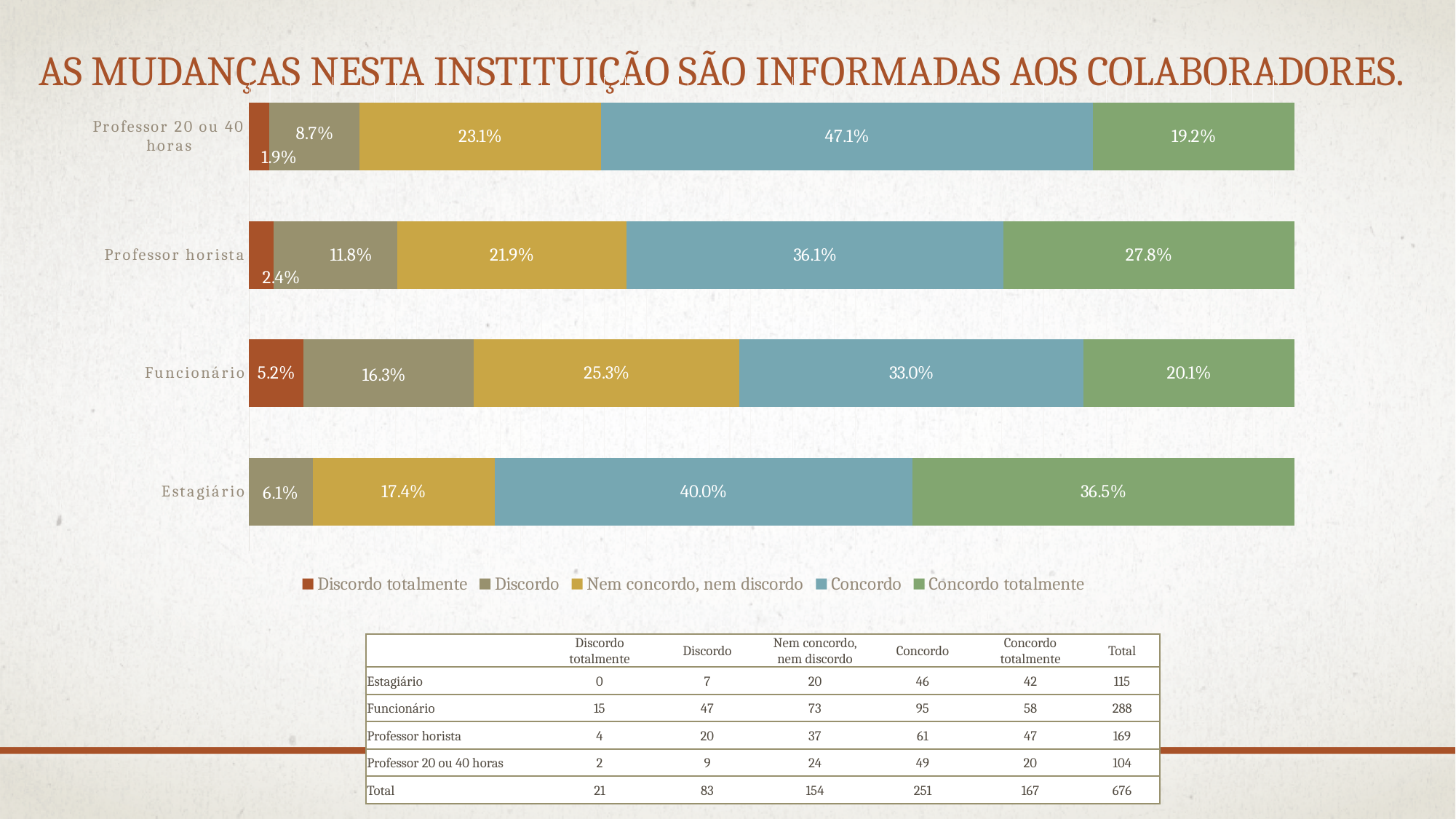
Which category has the lowest value for Concordo totalmente? Professor 20 ou 40 horas What kind of chart is shown on the slide? Stacked bar chart What is the value for Nem concordo, nem discordo for Professor horista? 21.9% How many series does the legend list? 5 Which category has the highest value for Concordo? Professor 20 ou 40 horas What is the difference between the Concordo totalmente values for Estagiário and Professor horista? 8.7 percentage points What is the value for Discordo totalmente for Funcionário? 5.2% Which is larger, the Nem concordo, nem discordo value for Funcionário or for Professor horista? Funcionário What is the value for Concordo for Professor 20 ou 40 horas? 47.1% How many categories are shown on the chart? 4 Which category has the highest value for Discordo? Funcionário What is the value for Concordo totalmente for Estagiário? 36.5%